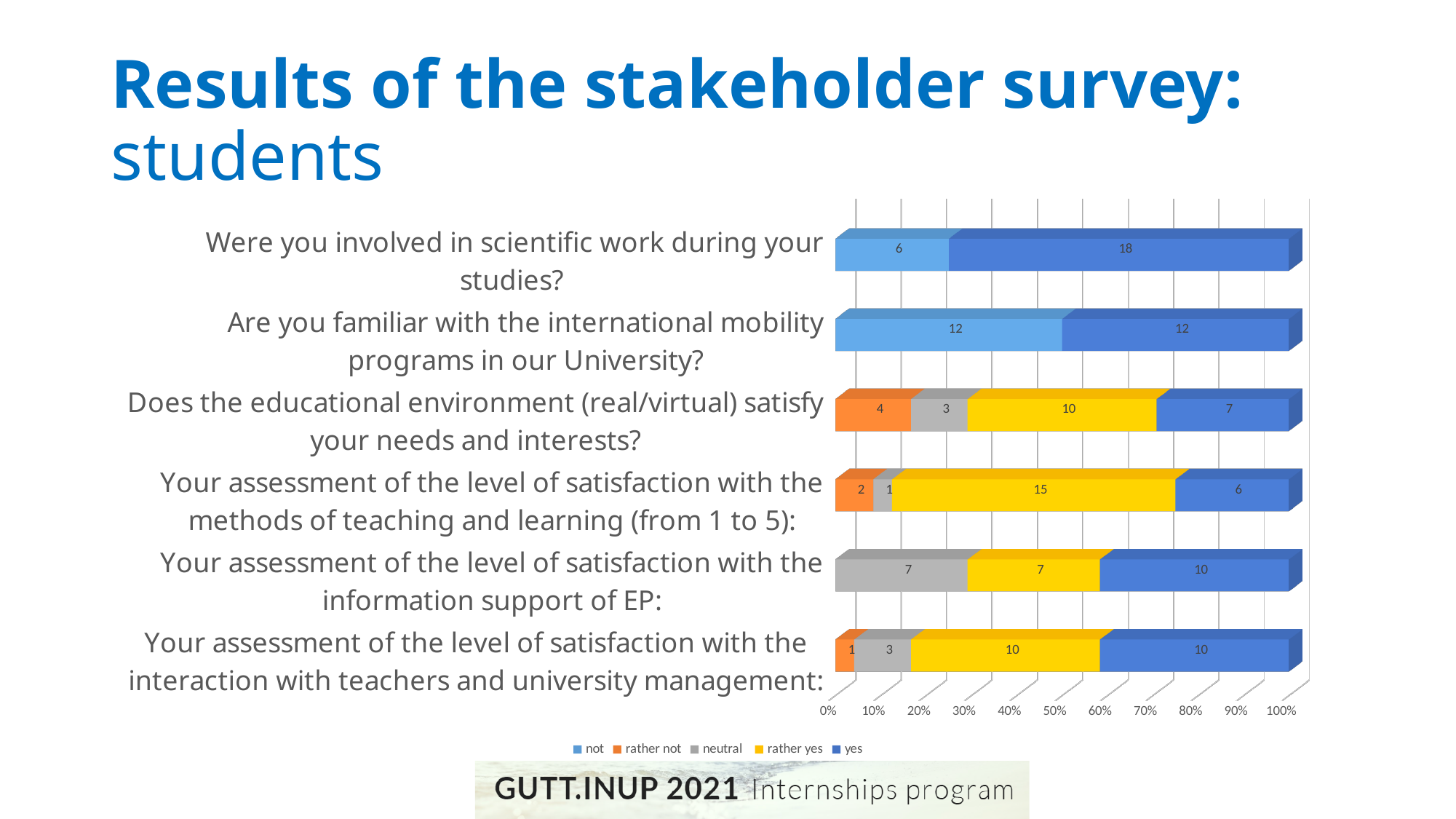
What is the 'rather not' value for 'Does the educational environment (real/virtual) satisfy your needs and interests?' 4 What is the difference between the 'yes' and 'not' values for 'Were you involved in scientific work during your studies?' 12 What is the 'rather yes' value for 'Your assessment of the level of satisfaction with the methods of teaching and learning (from 1 to 5):'? 15 How many survey questions (categories) are plotted in the chart? 6 What is the 'not' value for 'Are you familiar with the international mobility programs in our University?' 12 How many series does the legend list? 5 What is the total of the bar for 'Your assessment of the level of satisfaction with the interaction with teachers and university management:'? 24 Which colour represents the 'rather yes' series in the legend? yellow What is the 'neutral' value for 'Your assessment of the level of satisfaction with the information support of EP:'? 7 What is the 'yes' value for 'Were you involved in scientific work during your studies?' 18 Which series has the largest value in the bar for 'Does the educational environment (real/virtual) satisfy your needs and interests?' rather yes What kind of chart is shown on the slide? bar chart